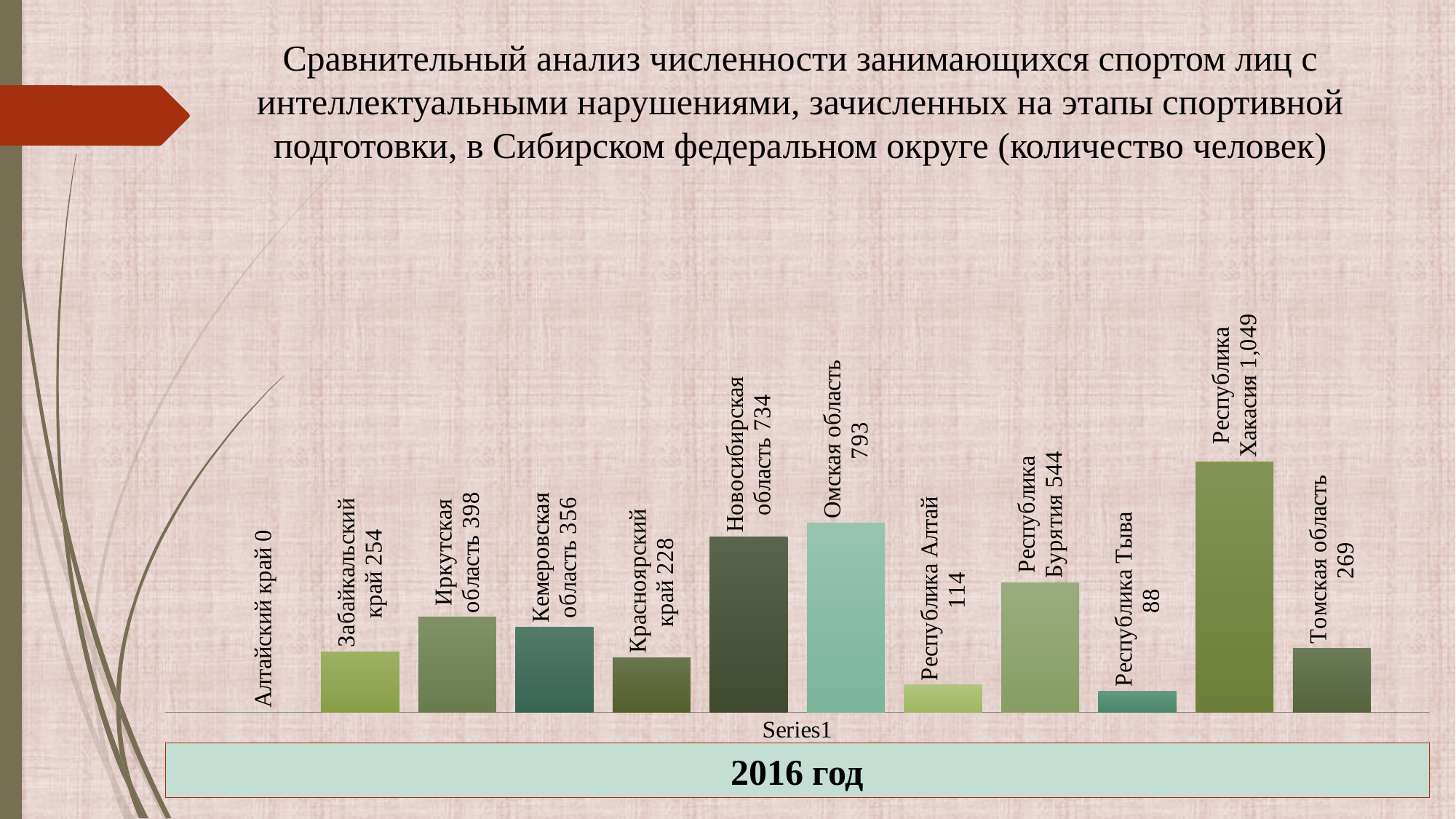
What is the value for Омская область? 793 What is the value for Красноярский край? 228 What is the difference between the values for Омская область and Новосибирская область? 59 What year is indicated in the caption below the chart? 2016 год Which is larger: the value for Иркутская область or the value for Кемеровская область? Иркутская область How many regions (bars) are plotted in the chart? 12 What is the value for Республика Алтай? 114 What type of chart is shown on the slide? bar chart Which region has the highest value in the chart? Республика Хакасия What is the value for Республика Бурятия? 544 What is the difference between the values for Республика Хакасия and Республика Тыва? 961 Which region has the lowest value in the chart? Алтайский край